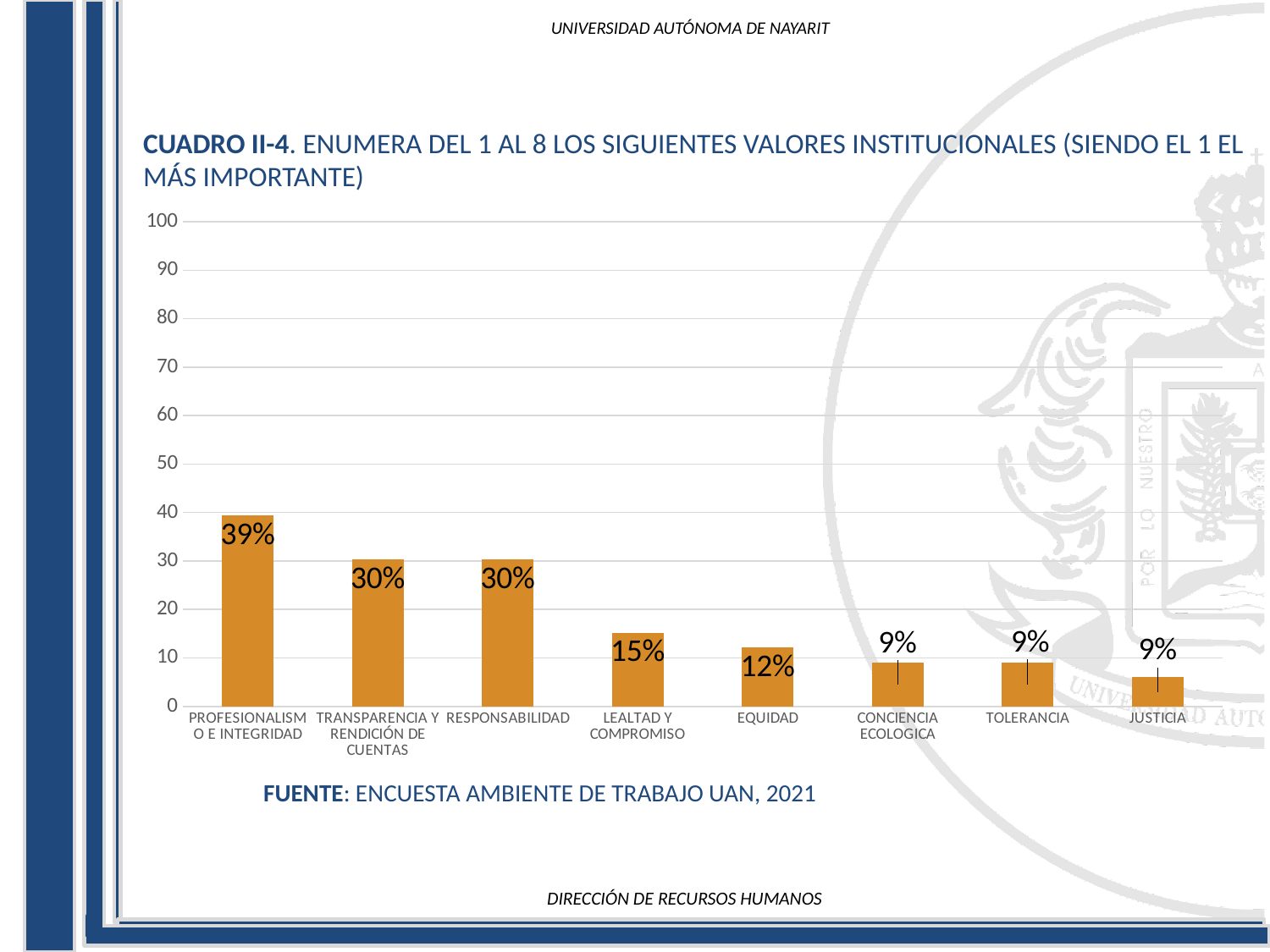
Which category has the highest value? PROFESIONALISMO E INTEGRIDAD What source is cited below the chart? ENCUESTA AMBIENTE DE TRABAJO UAN, 2021 What is the value for TOLERANCIA? 9% How many categories are shown on the x axis? 8 Is the value for PROFESIONALISMO E INTEGRIDAD greater or less than 50? less What is the value for LEALTAD Y COMPROMISO? 15% What kind of chart is shown on the slide? bar chart What is the value for PROFESIONALISMO E INTEGRIDAD? 39% What is the value for EQUIDAD? 12% What is the difference between the values for LEALTAD Y COMPROMISO and EQUIDAD? 3% Which is larger, the value for TRANSPARENCIA Y RENDICIÓN DE CUENTAS or the value for EQUIDAD? TRANSPARENCIA Y RENDICIÓN DE CUENTAS What is the difference between the values for PROFESIONALISMO E INTEGRIDAD and RESPONSABILIDAD? 9%